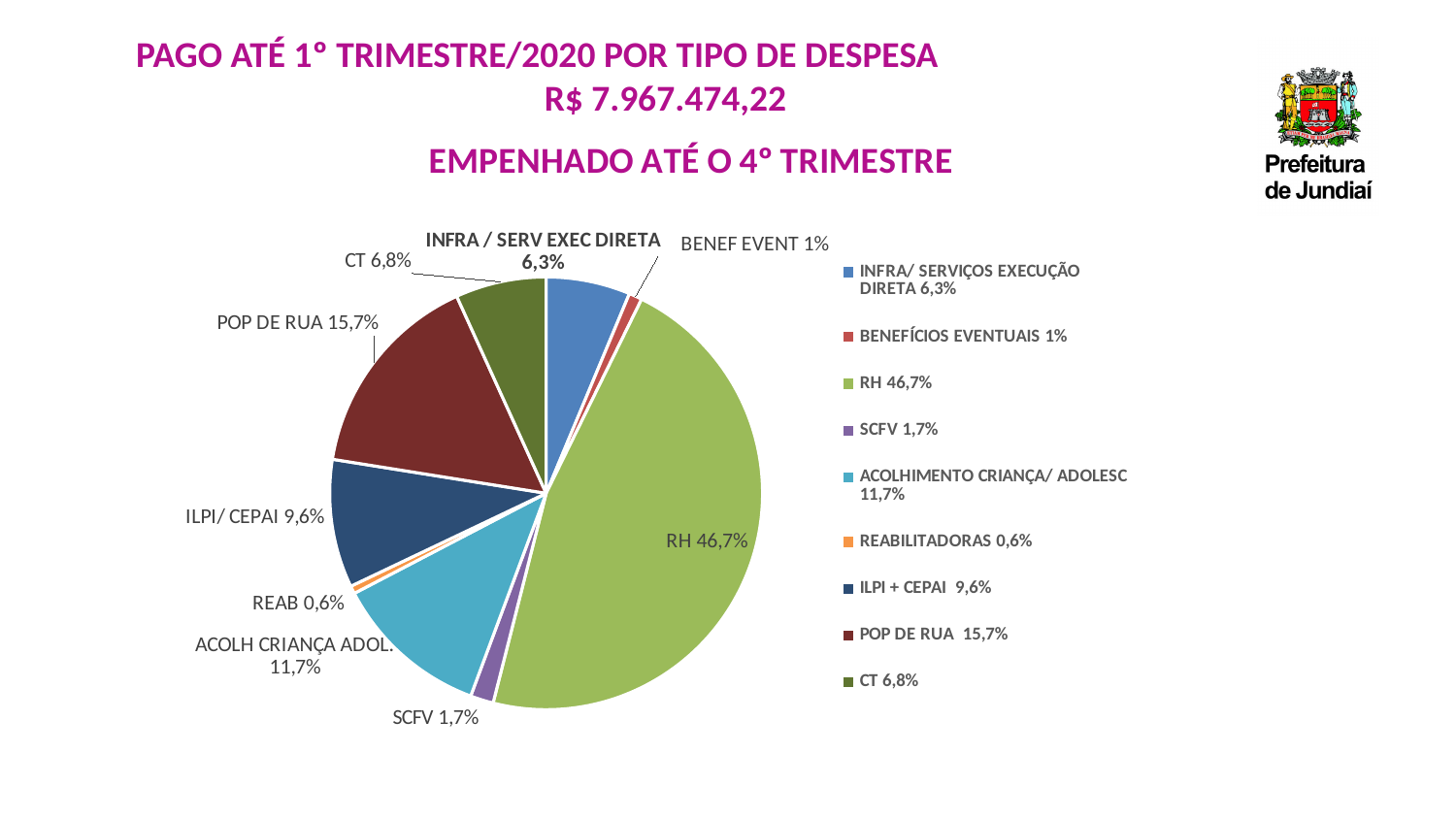
What total amount is stated in the chart title? R$ 7.967.474,22 What is the difference between the shares of POP DE RUA and ILPI + CEPAI? 6,1% Which category has the smallest slice of the pie? REABILITADORAS How many slices does the pie chart have? 9 How many entries does the legend list? 9 What is the value shown for ACOLHIMENTO CRIANÇA/ ADOLESC? 11,7% What is the value shown for CT? 6,8% Which category has the largest slice of the pie? RH What is the value shown for POP DE RUA? 15,7% Which is larger, the share for SCFV or the share for BENEFÍCIOS EVENTUAIS? SCFV What share of the pie does RH represent? 46,7% What kind of chart is shown on the slide? Pie chart